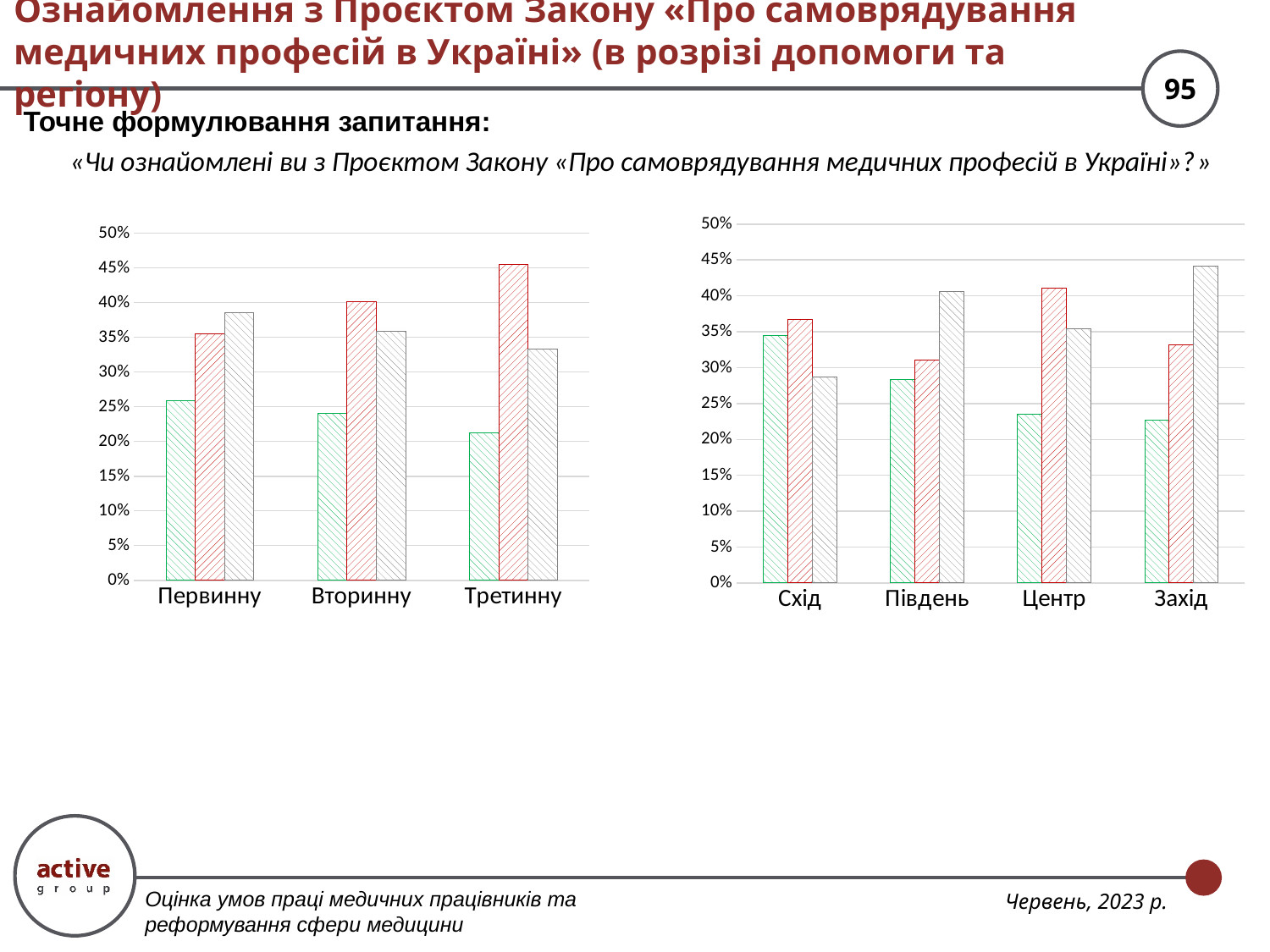
In the right chart, is the grey bar for Захід greater or less than 40%? greater In the right chart, which region has the highest green bar? Схід How many categories are shown on the x axis of the left chart? 3 What kind of chart is the left chart (Первинну, Вторинну, Третинну)? bar chart In the left chart, which category has the lowest green bar? Третинну How many regions are shown on the x axis of the right chart? 4 In the right chart, for Центр, which is larger: the red bar or the grey bar? the red bar In the left chart, do the green bars rise or fall from Первинну to Третинну? fall In the right chart, is the green bar for Схід greater or less than 30%? greater In the left chart, which category has the highest red bar? Третинну In the left chart, is the red bar for Третинну greater or less than 40%? greater